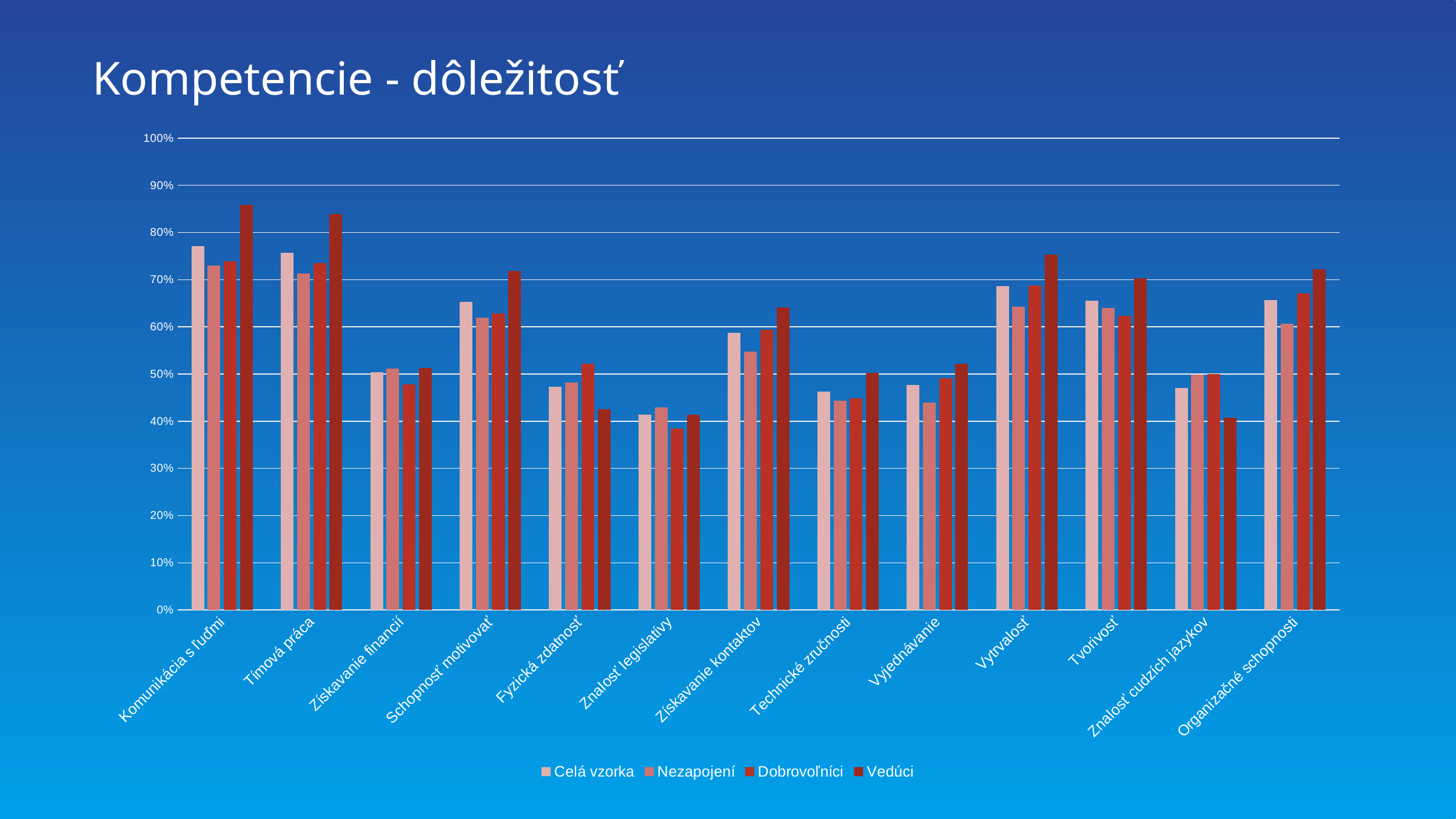
Is the Nezapojení value for Získavanie kontaktov greater or less than 60%? less For Znalosť cudzích jazykov, which is larger: the Nezapojení value or the Vedúci value? Nezapojení For Schopnosť motivovať, which is larger: the Vedúci value or the Celá vzorka value? Vedúci Is the Dobrovoľníci value for Znalosť legislatívy greater or less than 40%? less For which category is the Vedúci bar the highest? Komunikácia s ľuďmi How many series does the legend list? 4 What is the title of the slide? Kompetencie - dôležitosť What kind of chart is shown on the slide? bar chart Is the Celá vzorka value for Vytrvalosť greater or less than 60%? greater For which category is the Celá vzorka bar the lowest? Znalosť legislatívy How many competency categories are shown on the x axis? 13